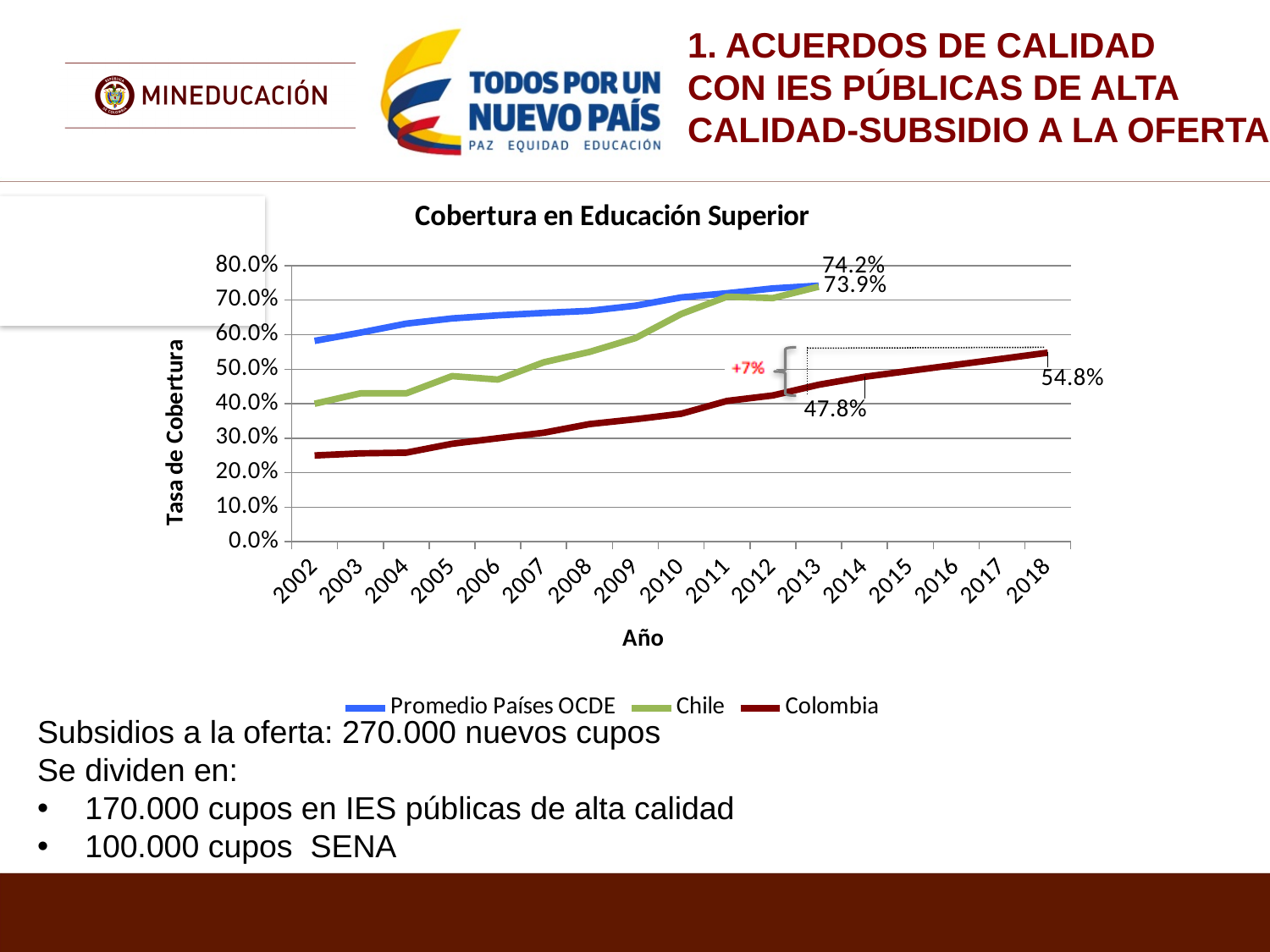
How many series does the chart legend list? 3 What is the labelled value for Chile in 2013? 73.9% Which series has the lowest value in 2002? Colombia How many years are shown on the x axis of the chart? 17 What is the labelled value for Promedio Países OCDE in 2013? 74.2% What is the title of the chart? Cobertura en Educación Superior What type of chart is shown on the slide? line chart What is the labelled value for Colombia in 2018? 54.8% Does the Colombia line rise or fall from 2002 to 2018? rise Which series are listed in the chart legend? Promedio Países OCDE, Chile, Colombia